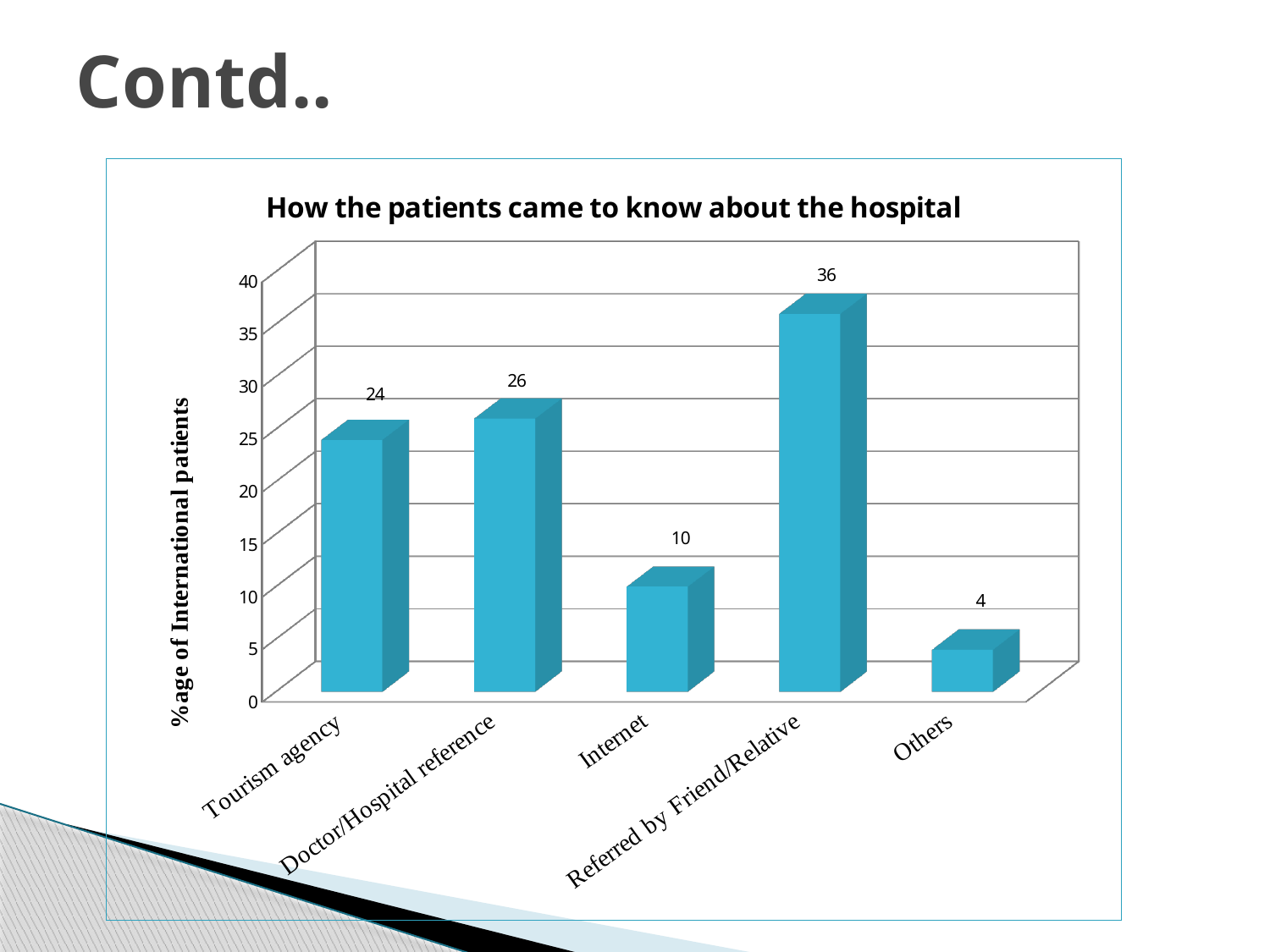
What is the difference between the values for Doctor/Hospital reference and Tourism agency? 2 Which category has the lowest value? Others How many categories are shown on the x axis? 5 Which category has the highest value? Referred by Friend/Relative What is the title of the chart? How the patients came to know about the hospital What is the value for Referred by Friend/Relative? 36 What is the value for Tourism agency? 24 Is the value for Doctor/Hospital reference greater or less than 20? greater What kind of chart is this? bar chart What is the value for Internet? 10 What is the difference between the values for Referred by Friend/Relative and Others? 32 Which is larger, the value for Internet or the value for Others? Internet